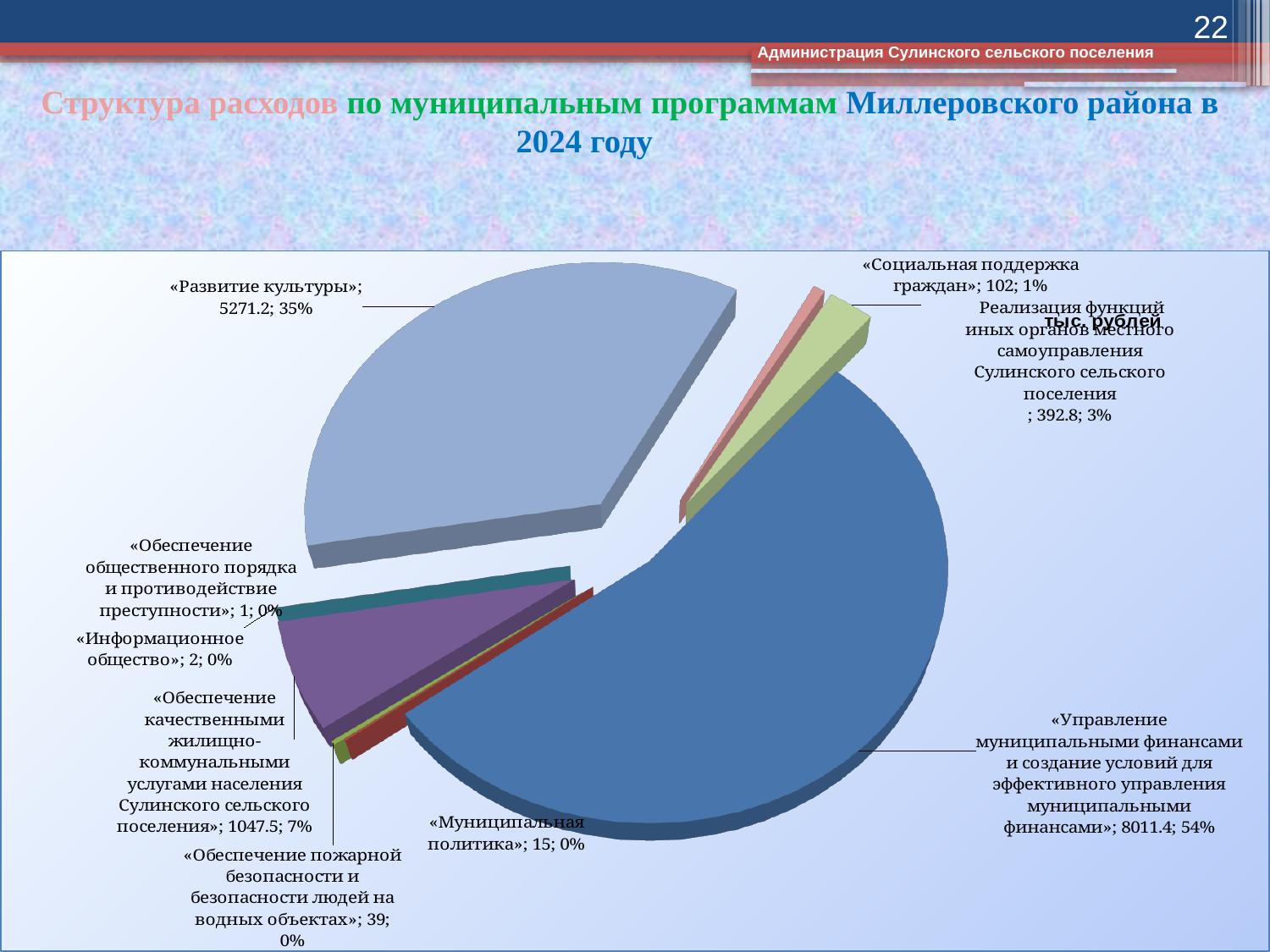
What is the value for «Развитие культуры»? 5271.2 In what units are the values on the chart given? тыс. рублей What share of the pie does «Реализация функций иных органов местного самоуправления Сулинского сельского поселения» represent? 3% Which category has the largest slice of the pie? «Управление муниципальными финансами и создание условий для эффективного управления муниципальными финансами» What is the value for «Обеспечение пожарной безопасности и безопасности людей на водных объектах»? 39 How many slices does the pie chart have? 9 Which category has the smallest value? «Обеспечение общественного порядка и противодействие преступности» What is the difference between the values for «Управление муниципальными финансами...» (8011.4) and «Развитие культуры» (5271.2)? 2740.2 What share of the pie does «Управление муниципальными финансами и создание условий для эффективного управления муниципальными финансами» represent? 54% What kind of chart is shown on the slide? pie chart What is the value for «Обеспечение качественными жилищно-коммунальными услугами населения Сулинского сельского поселения»? 1047.5 Which is larger: the value for «Социальная поддержка граждан» or for «Муниципальная политика»? «Социальная поддержка граждан»